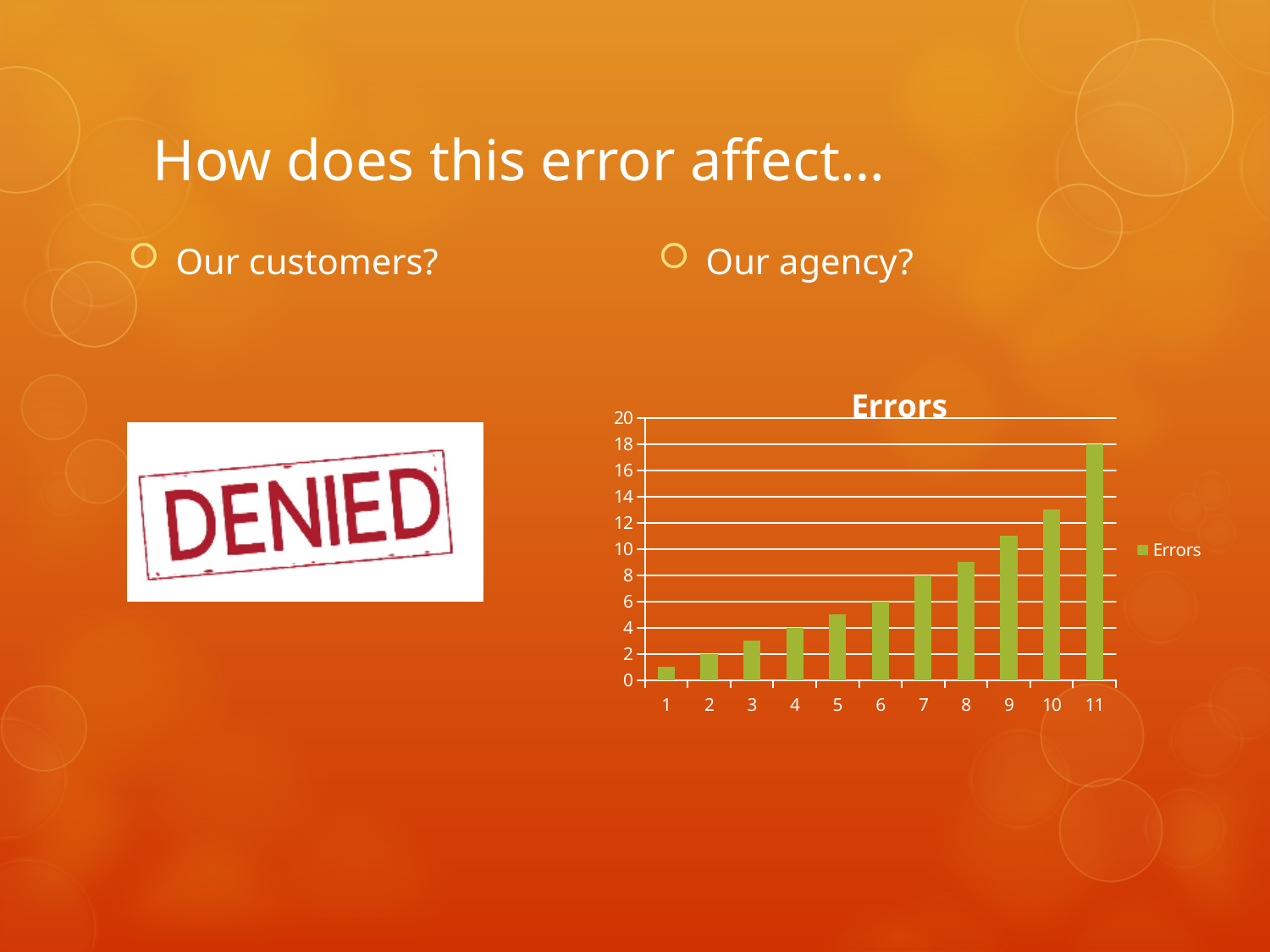
What is the value for category 4 in the Errors chart? 4 Which is larger in the Errors chart, the value for category 9 or the value for category 5? 9 How many categories are shown on the x axis of the Errors chart? 11 Is the value for category 10 greater or less than 12? greater What is the value for category 7 in the Errors chart? 8 Which category has the highest value in the Errors chart? 11 Do the values in the Errors chart rise or fall from category 1 to category 11? rise What is the value for category 11 in the Errors chart? 18 How many series does the legend list? 1 What kind of chart is shown on the slide? bar chart What is the title of the chart? Errors Which category has the lowest value in the Errors chart? 1